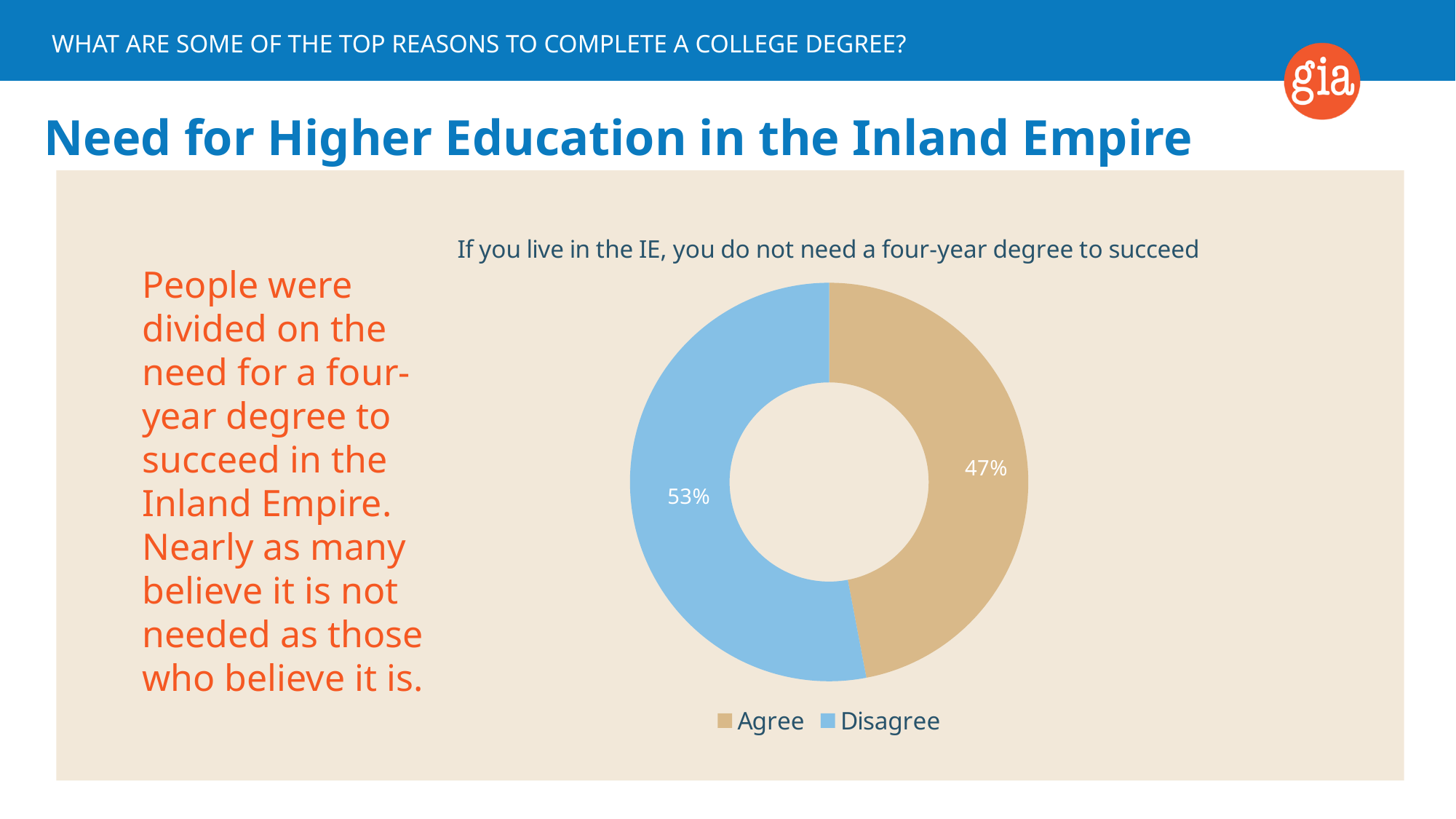
What is the title of the chart? If you live in the IE, you do not need a four-year degree to succeed How many categories are shown in the chart? 2 Is the share for Disagree greater or less than 50%? greater What is the difference in percentage points between the Disagree and Agree shares? 6 percentage points Is the share for Agree greater or less than 50%? less Which response has the smaller share in the chart? Agree What percentage of respondents agree that if you live in the IE, you do not need a four-year degree to succeed? 47% What kind of chart is shown on the slide? Doughnut (pie) chart How many entries does the chart legend list? 2 Which colour represents Disagree in the chart? Blue Which response has the larger share in the chart, Agree or Disagree? Disagree What percentage of respondents disagree with the statement in the chart? 53%